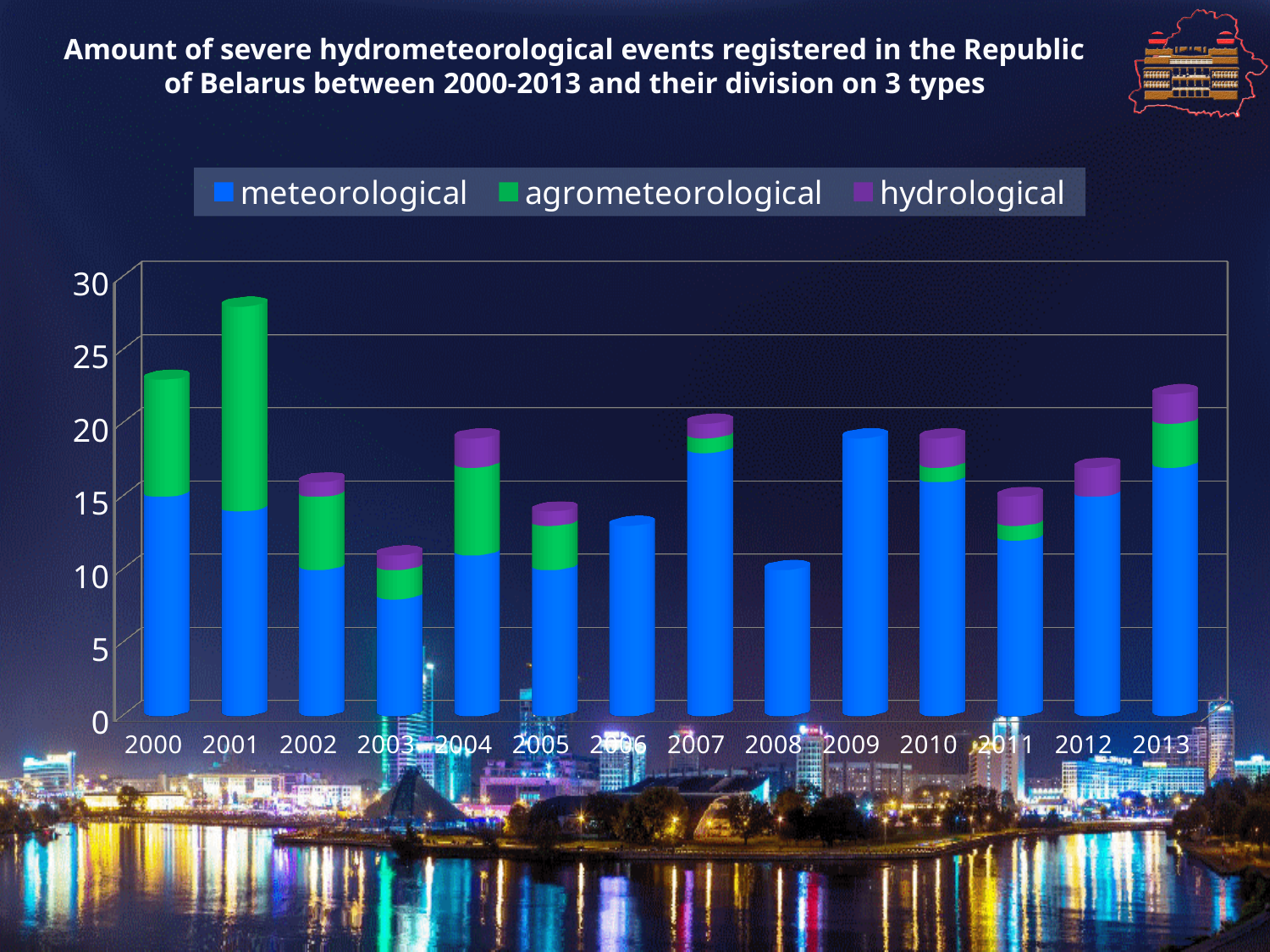
How many years are shown along the x axis? 14 Which year has the larger total, 2012 or 2013? 2013 Which year has the highest total number of severe hydrometeorological events? 2001 Is the total value for 2008 greater or less than 15? less Which colour represents the hydrological series in the legend? purple Is the total value for 2001 greater or less than 25? greater Which year has the largest agrometeorological segment? 2001 What kind of chart is shown on the slide? bar chart Which year has the larger total, 2000 or 2002? 2000 Is the total value for 2003 greater or less than 15? less How many series does the legend list? 3